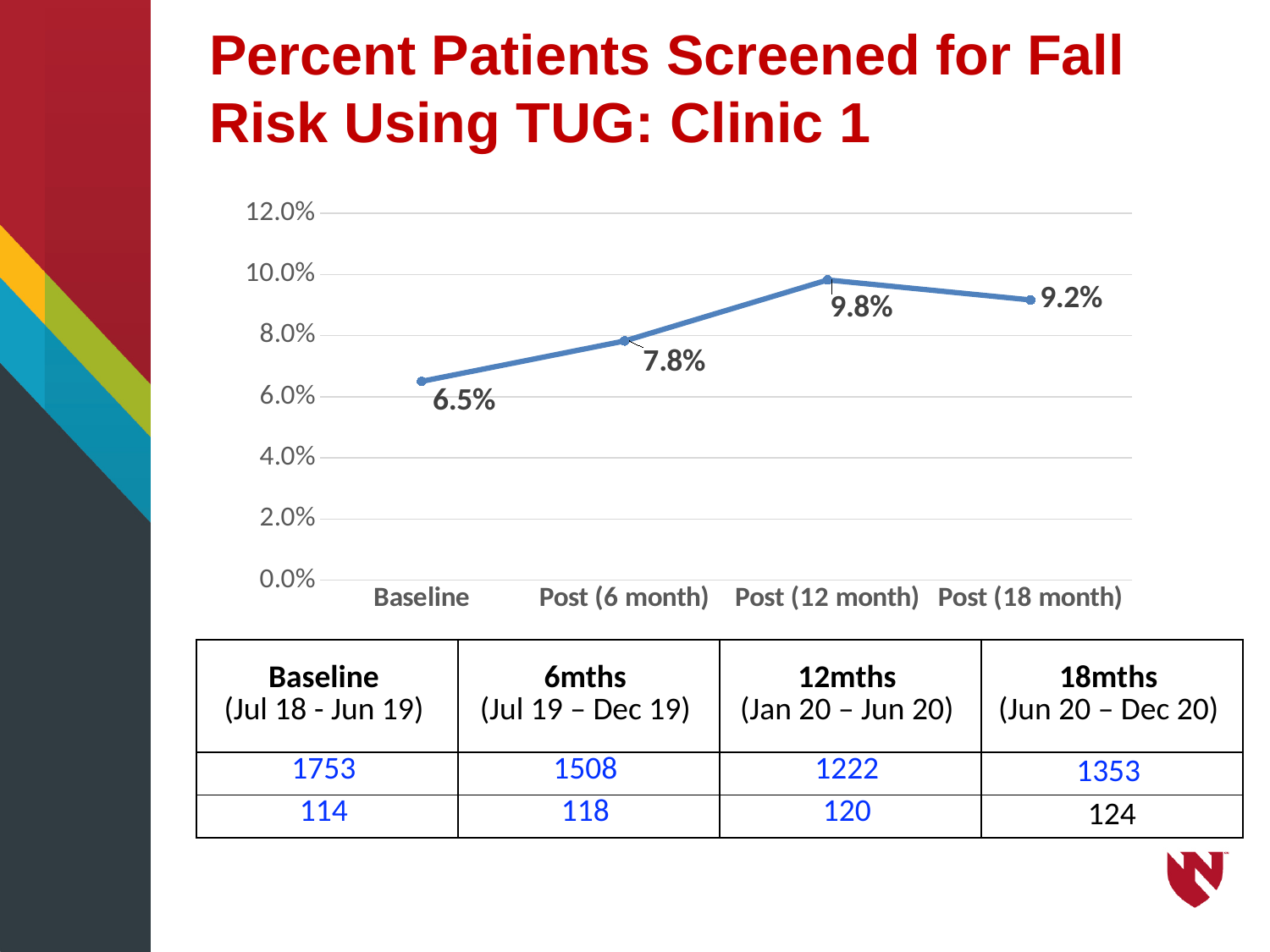
What is the value for Post (6 month)? 7.8% Which is larger, the value for Post (6 month) or Post (18 month)? Post (18 month) What is the value for Post (12 month)? 9.8% What is the value for Post (18 month)? 9.2% What kind of chart is shown on the slide? line chart Is the value for Post (12 month) greater or less than 8.0%? greater Does the value rise or fall from Post (12 month) to Post (18 month)? fall What is the value for Baseline? 6.5% Which category has the lowest value? Baseline What is the difference between the Post (12 month) and Baseline values? 3.3% Which category has the highest value? Post (12 month) How many data points are plotted on the chart? 4